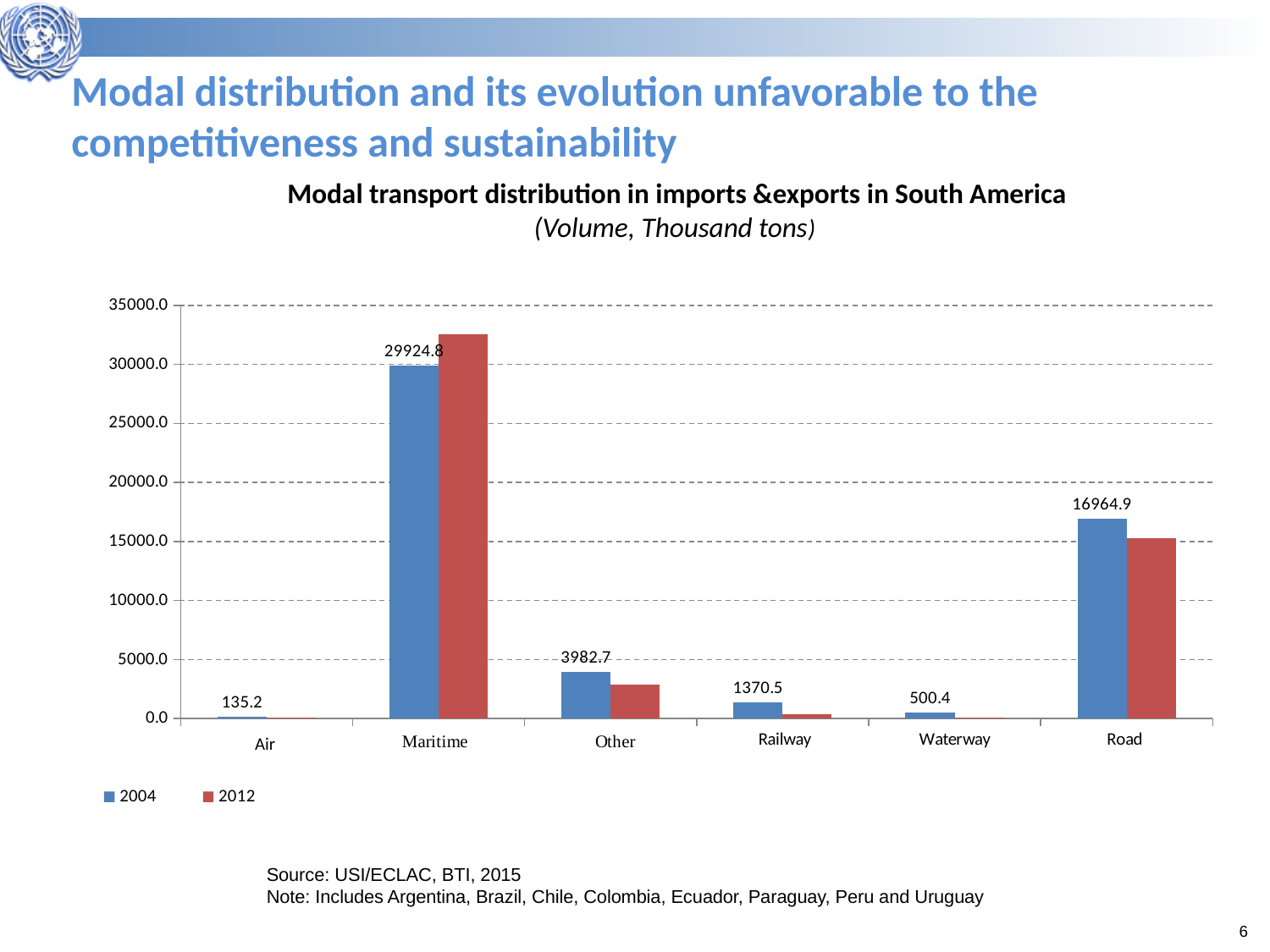
What is the 2004 value for Air? 135.2 What is the 2004 value for Maritime? 29924.8 Is the 2012 value for Maritime greater or less than 30000? greater How many series does the legend list? 2 For Maritime, which year has the larger value, 2004 or 2012? 2012 What is the 2004 value for Waterway? 500.4 Which transport mode has the highest 2004 value? Maritime For Road, which year has the larger value, 2004 or 2012? 2004 How many transport modes are shown on the x axis? 6 Which transport mode has the lowest 2004 value? Air What is the 2004 value for Road? 16964.9 What is the difference between the 2004 values for Other and Railway? 2612.2